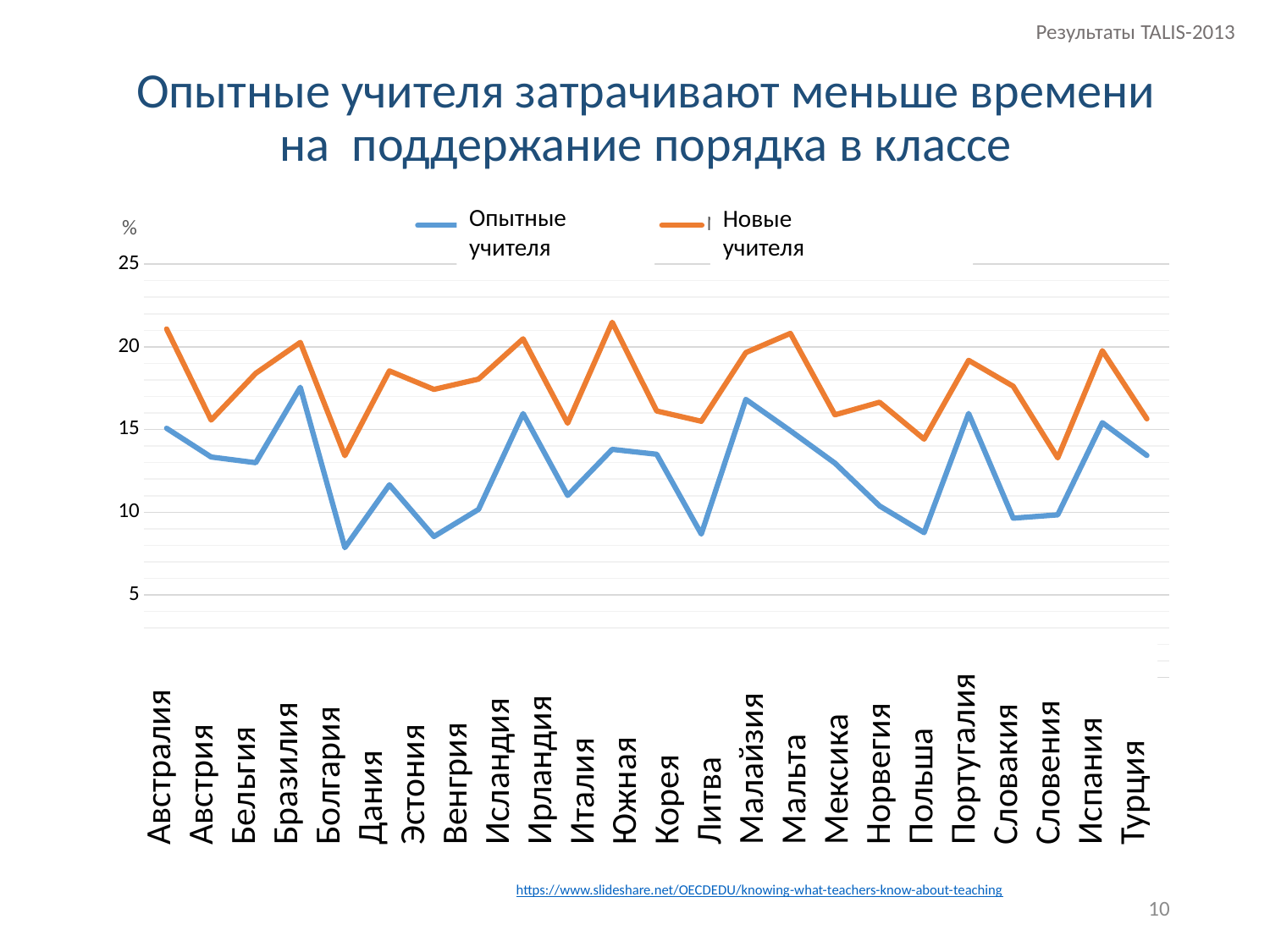
In Австралия, which series has the larger value, Опытные учителя or Новые учителя? Новые учителя Is the value for Опытные учителя in Бразилия greater or less than 15? greater Which series is drawn in orange? Новые учителя Is the value for Новые учителя in Болгария greater or less than 15? less For Опытные учителя, which has the larger value, Бразилия or Болгария? Бразилия Is the value for Новые учителя in Австралия greater or less than 20? greater What kind of chart is shown on the slide? line chart How many series does the legend list? 2